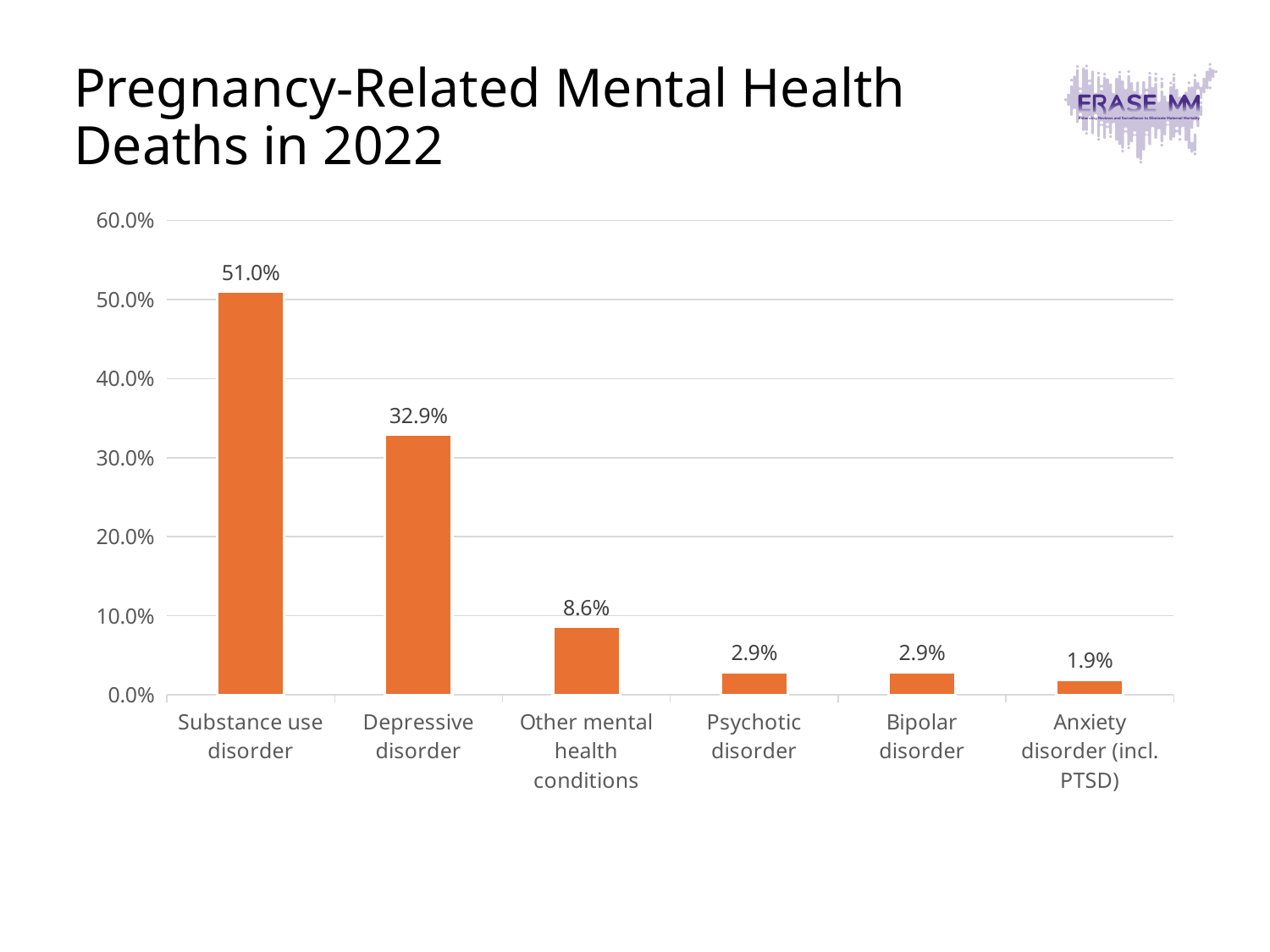
What is the value for Substance use disorder? 51.0% Which category has the lowest value? Anxiety disorder (incl. PTSD) How many categories are shown on the x axis? 6 What is the difference between the values for Substance use disorder and Depressive disorder? 18.1% What is the title of the chart on the slide? Pregnancy-Related Mental Health Deaths in 2022 Is the value for Substance use disorder greater or less than 50.0%? greater What kind of chart is shown on the slide? bar chart What is the value for Other mental health conditions? 8.6% Which category has the highest value? Substance use disorder What is the value for Anxiety disorder (incl. PTSD)? 1.9% What is the value for Depressive disorder? 32.9% Which is larger, the value for Depressive disorder or the value for Other mental health conditions? Depressive disorder